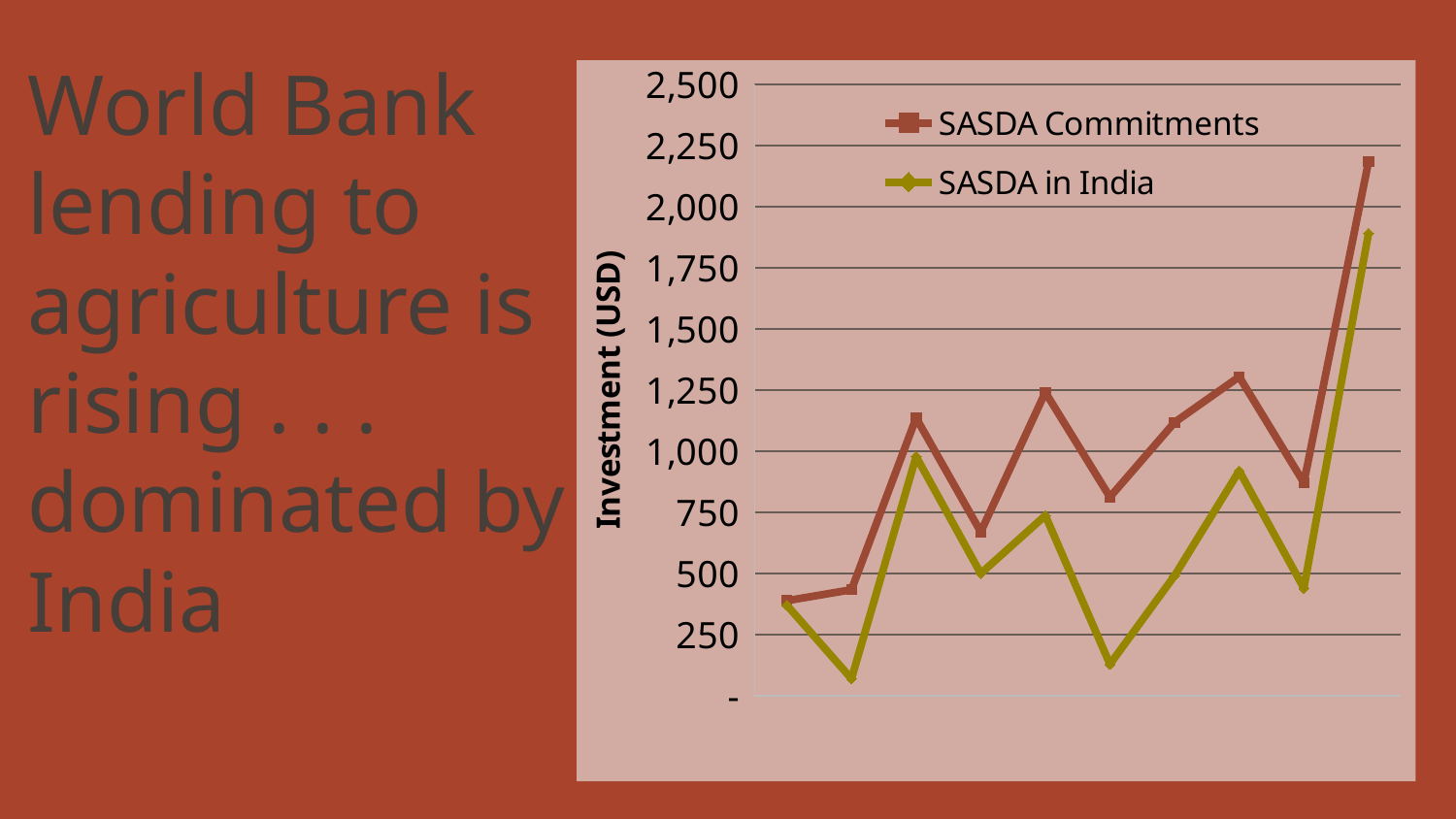
Which point of the SASDA Commitments series is the highest, the first or the last? The last What are the two series named in the chart's legend? SASDA Commitments and SASDA in India Is the lowest point of the SASDA Commitments series greater or less than 500? less Does the SASDA Commitments series end higher or lower than it starts? Higher What is the title of the chart's vertical axis? Investment (USD) Is the lowest point of the SASDA in India series greater or less than 250? less How many series does the chart's legend list? 2 What kind of chart is shown on the slide? Line chart Is the highest point of the SASDA in India series greater or less than 1,750? greater What is the highest value shown on the chart's vertical axis? 2,500 At the final point on the chart, which series has the higher value, SASDA Commitments or SASDA in India? SASDA Commitments